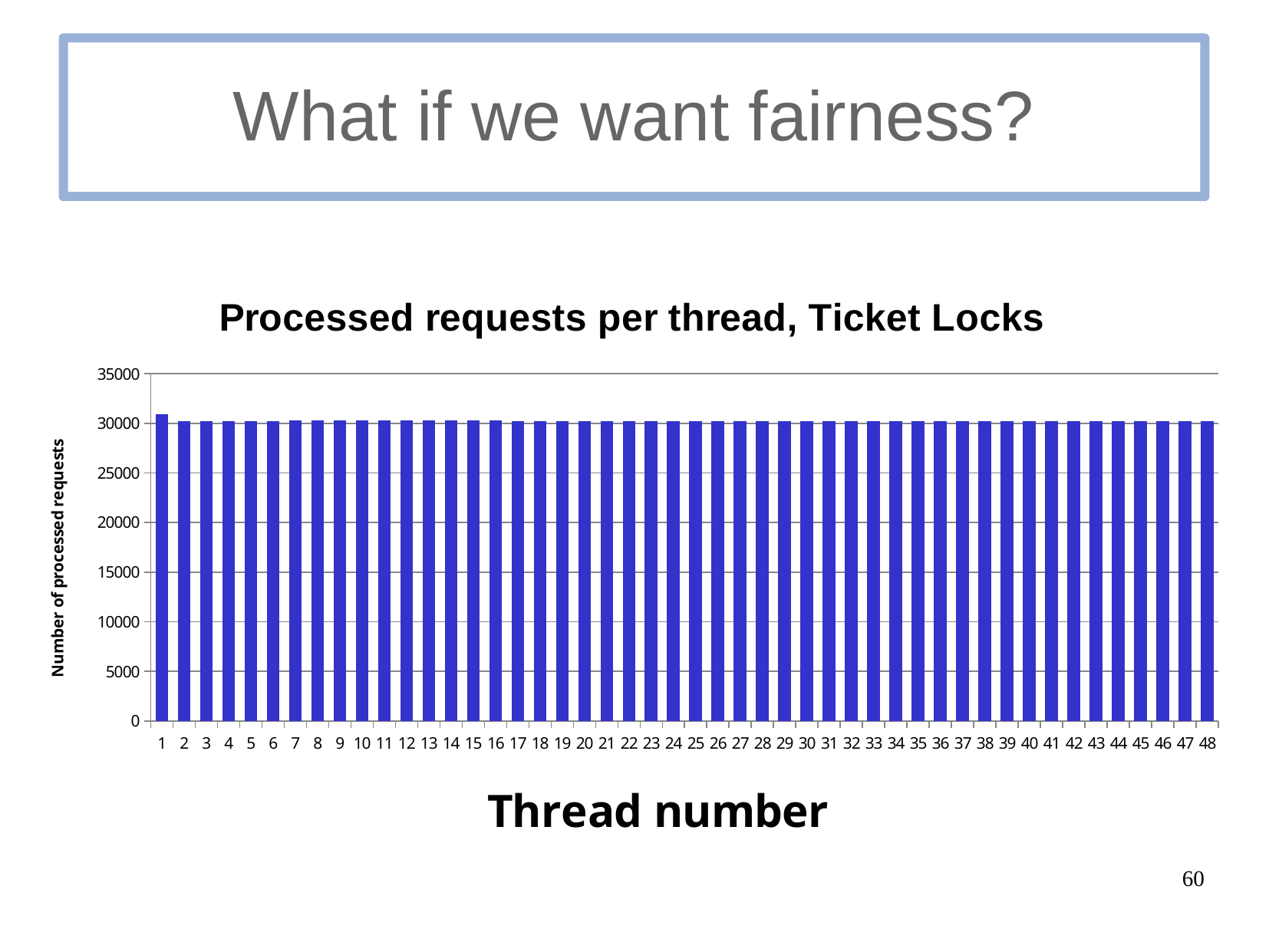
What is the label of the x axis? Thread number What is the highest value shown on the y axis? 35000 Is the value for thread 48 greater or less than 35000? less Which is larger, the value for thread 1 or the value for thread 2? Thread 1 Is the value for thread 1 greater or less than 30000? greater What is the title of the chart? Processed requests per thread, Ticket Locks How many threads (bars) are plotted in the chart? 48 Is the value for thread 25 greater or less than 20000? greater What kind of chart is shown on the slide? Bar chart Do the values rise, fall, or stay roughly flat across thread numbers 2 to 48? Stay roughly flat Which thread has the highest number of processed requests? Thread 1